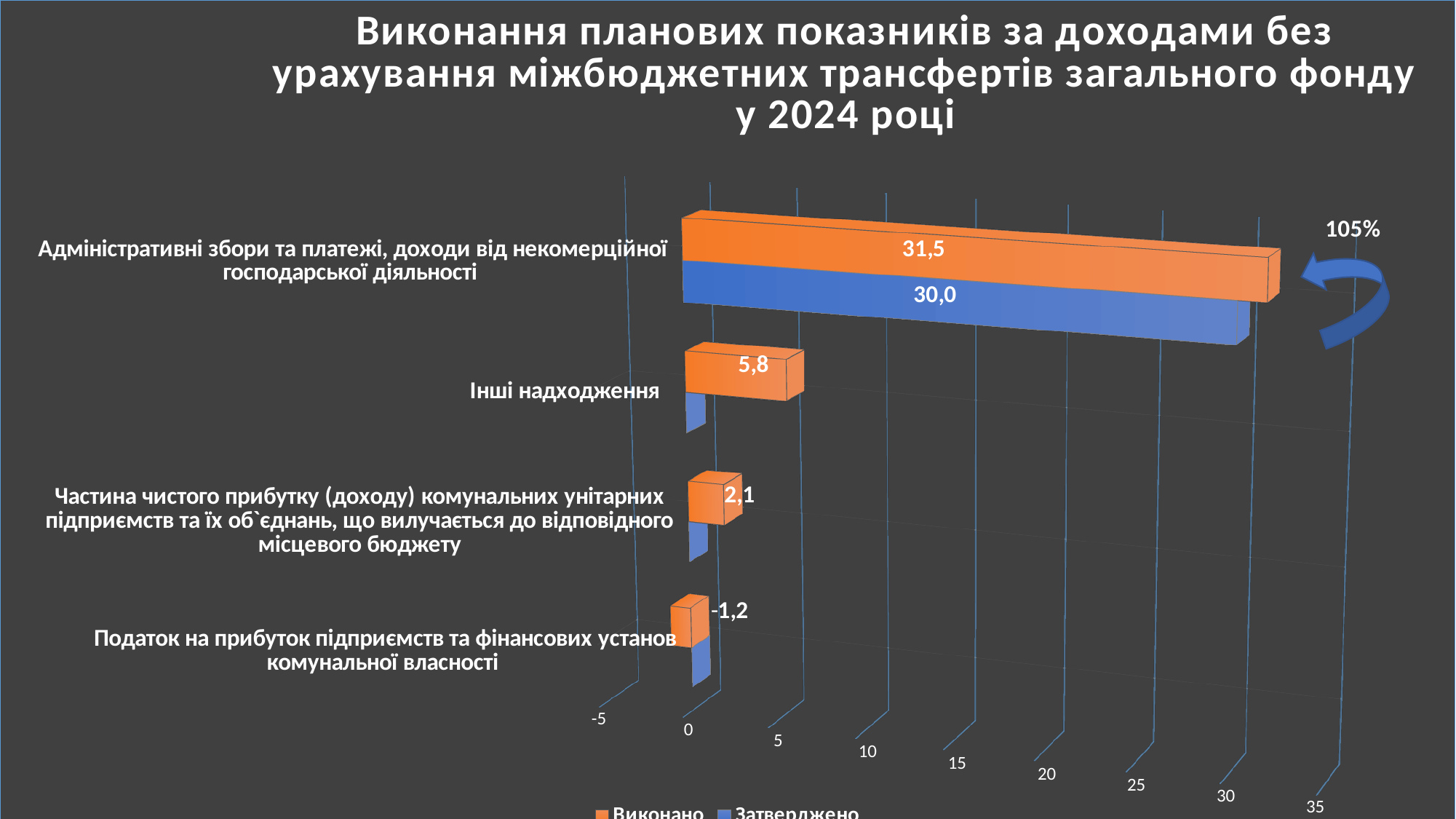
What is the Виконано value for Адміністративні збори та платежі, доходи від некомерційної господарської діяльності? 31,5 What type of chart is shown on the slide? Bar chart How many categories are shown on the chart? 4 What is the Виконано value for Податок на прибуток підприємств та фінансових установ комунальної власності? -1,2 What is the Виконано value for Інші надходження? 5,8 Which category has the lowest Виконано value? Податок на прибуток підприємств та фінансових установ комунальної власності What is the Виконано value for Частина чистого прибутку (доходу) комунальних унітарних підприємств? 2,1 How many series does the legend list? 2 What is the difference between the Виконано and Затверджено values for Адміністративні збори та платежі? 1,5 For Адміністративні збори та платежі, which is larger: Виконано or Затверджено? Виконано Which category has the highest Виконано value? Адміністративні збори та платежі, доходи від некомерційної господарської діяльності What is the Затверджено value for Адміністративні збори та платежі, доходи від некомерційної господарської діяльності? 30,0